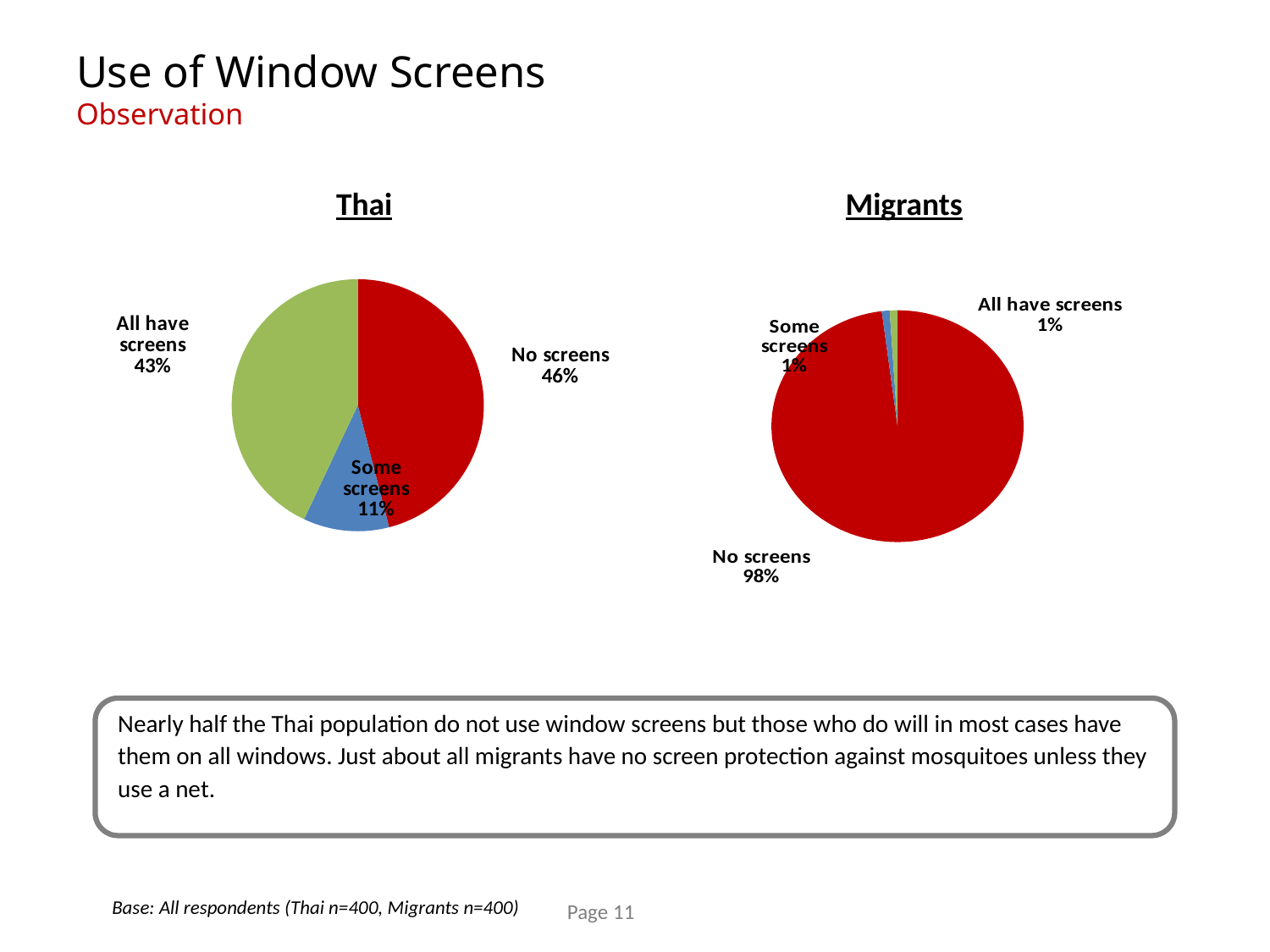
Which is larger in the Thai pie chart: the share with all screens or the share with some screens? All have screens In the Thai pie chart, what is the difference between the No screens share and the All have screens share? 3% In the Migrants pie chart, which category has the largest share? No screens In the Thai pie chart, what share of respondents have screens on all windows? 43% What type of chart is used for the Migrants data? Pie chart In the Migrants pie chart, what share of respondents have no screens? 98% In the Thai pie chart, what share of respondents have some screens? 11% How many slices does the Thai pie chart have? 3 In the Thai pie chart, what share of respondents have no screens? 46% In the Migrants pie chart, what share of respondents have all screens? 1% In the Thai pie chart, which category has the smallest share? Some screens In the Thai pie chart, which category has the largest share? No screens